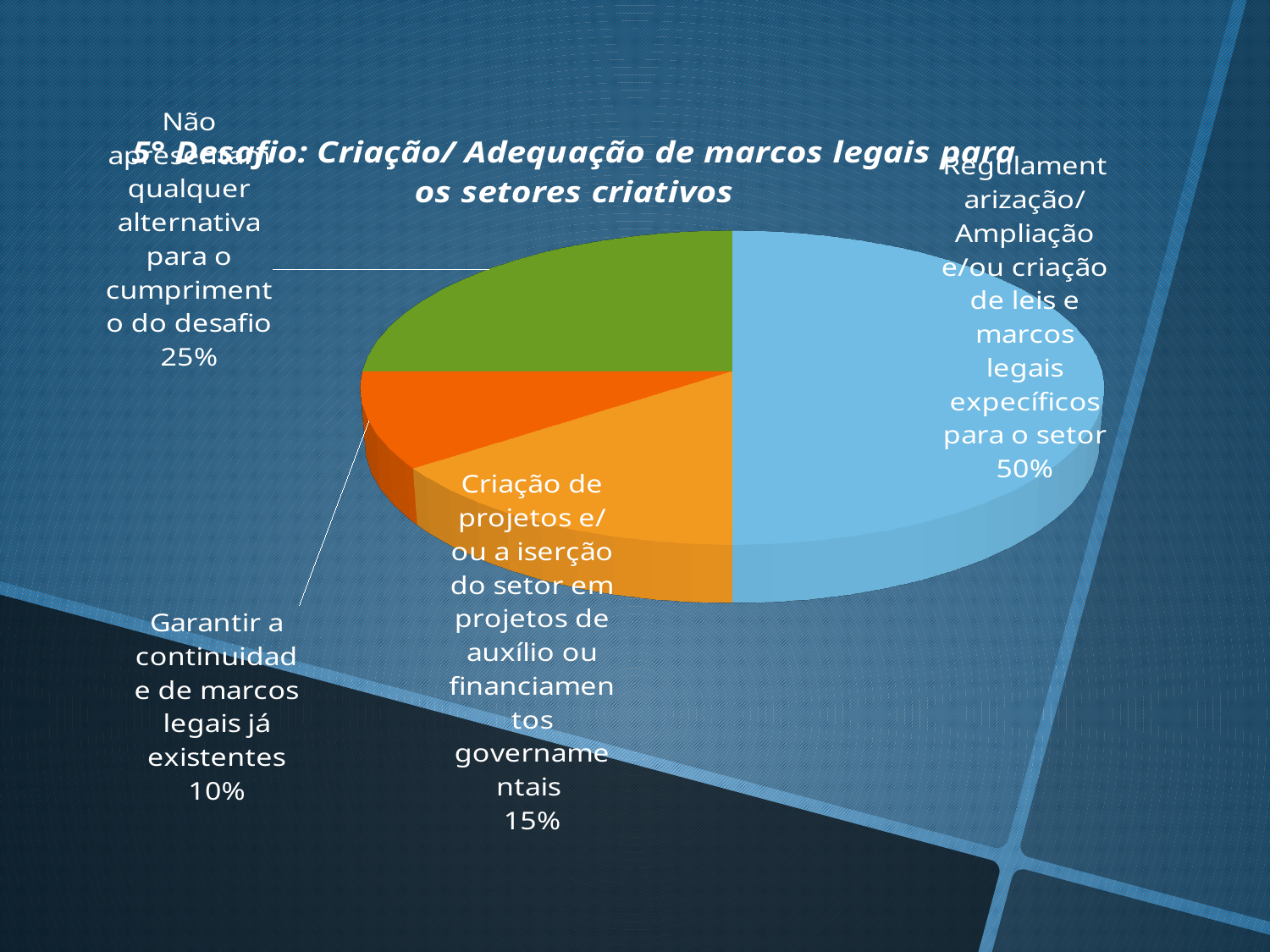
Which slice of the pie chart is the smallest? Garantir a continuidade de marcos legais já existentes Which slice of the pie chart is the largest? Regulamentarização/ Ampliação e/ou criação de leis e marcos legais expecíficos para o setor What percentage is shown for "Garantir a continuidade de marcos legais já existentes"? 10% What percentage is shown for the slice about "Criação de projetos e/ou a iserção do setor em projetos de auxílio ou financiamentos governamentais"? 15% How many slices does the pie chart have? 4 What is the title of the chart on the slide? 5º Desafio: Criação/ Adequação de marcos legais para os setores criativos Which is larger: the share for "Criação de projetos" or the share for "Garantir a continuidade de marcos legais já existentes"? Criação de projetos What is the difference in percentage points between the "Regulamentarização" slice (50%) and the "Não apresentam qualquer alternativa" slice (25%)? 25 percentage points What share of the pie is labelled "Regulamentarização/ Ampliação e/ou criação de leis e marcos legais expecíficos para o setor"? 50% What kind of chart is shown on the slide? Pie chart What colour is the slice representing 50% of the pie? Blue What percentage is shown for "Não apresentam qualquer alternativa para o cumprimento do desafio"? 25%